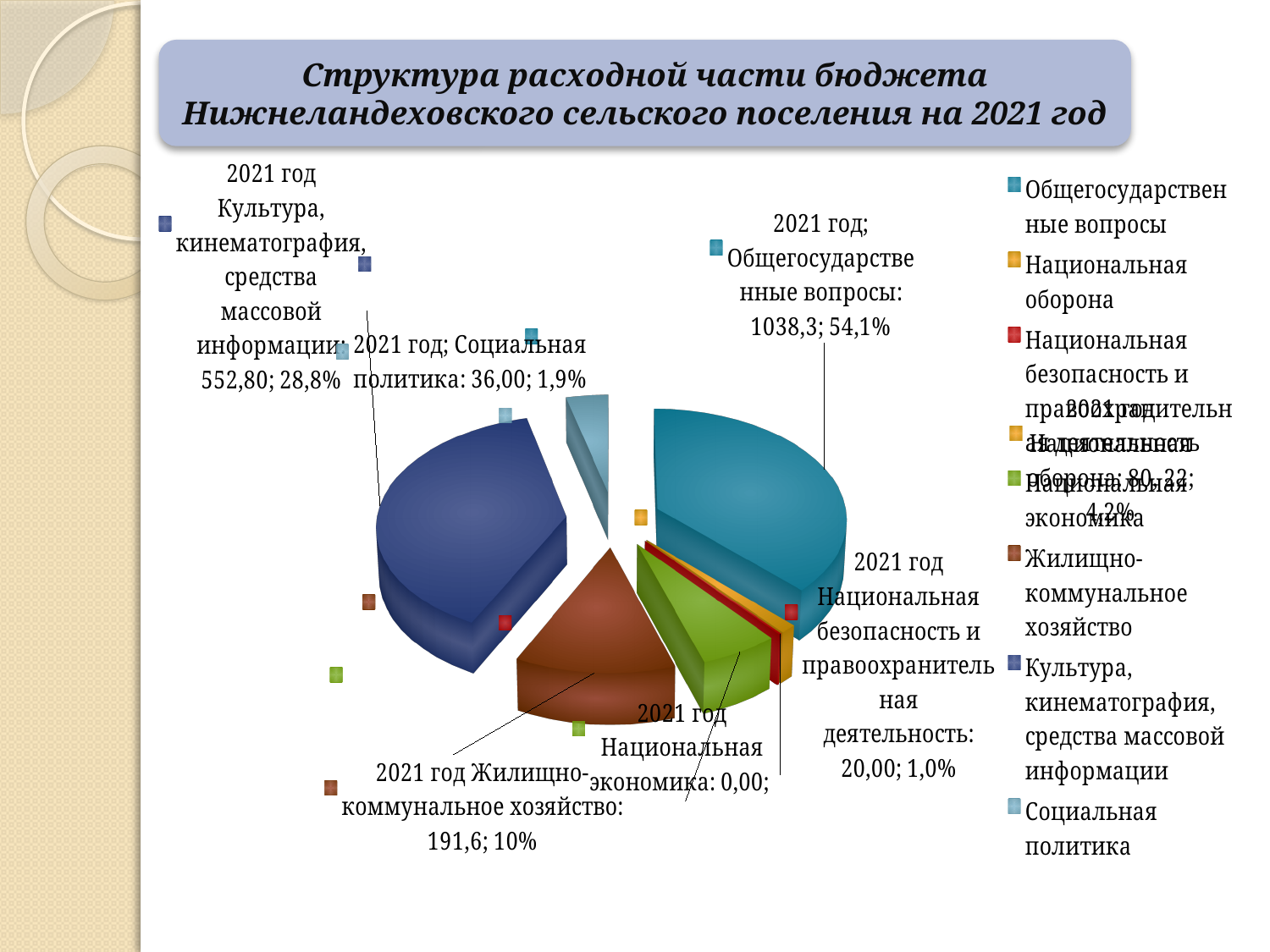
What is the value shown for Культура, кинематография, средства массовой информации? 552,80 What kind of chart is shown on the slide? Pie chart What share of the pie does Общегосударственные вопросы represent? 54,1% Which category has the largest share of the pie? Общегосударственные вопросы How many categories does the legend list? 7 Which category has the smallest value in the chart? Национальная экономика Which is larger: the value for Жилищно-коммунальное хозяйство or the value for Социальная политика? Жилищно-коммунальное хозяйство What share of the pie does Жилищно-коммунальное хозяйство represent? 10% What is the value shown for Национальная экономика? 0,00 What is the value shown for Общегосударственные вопросы? 1038,3 What is the value shown for Национальная безопасность и правоохранительная деятельность? 20,00 What is the value shown for Социальная политика? 36,00